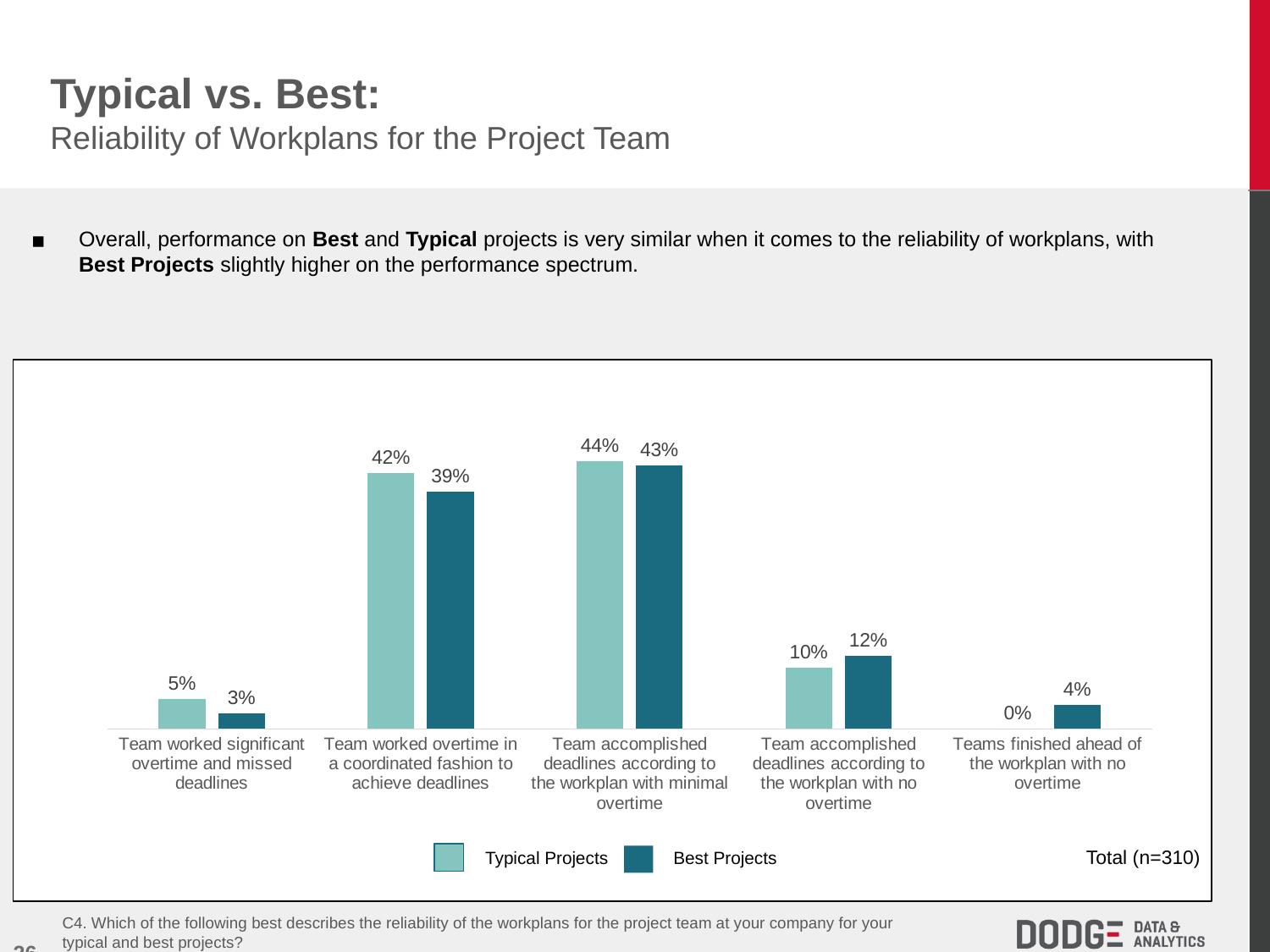
Which category has the lowest value for Typical Projects? Teams finished ahead of the workplan with no overtime What is the difference between Typical Projects and Best Projects in the category 'Team worked overtime in a coordinated fashion to achieve deadlines'? 3% How many series does the legend list? 2 Which category has the highest value for Best Projects? Team accomplished deadlines according to the workplan with minimal overtime How many categories are shown on the x axis of the chart? 5 What kind of chart is shown on the slide? Bar chart What is the value for Typical Projects in the category 'Team worked overtime in a coordinated fashion to achieve deadlines'? 42% In the category 'Team worked significant overtime and missed deadlines', which is larger: Typical Projects or Best Projects? Typical Projects What is the value for Best Projects in the category 'Team accomplished deadlines according to the workplan with minimal overtime'? 43% What is the value for Best Projects in the category 'Team accomplished deadlines according to the workplan with no overtime'? 12% What is the sample size shown next to the legend? Total (n=310) What is the value for Typical Projects in the category 'Teams finished ahead of the workplan with no overtime'? 0%